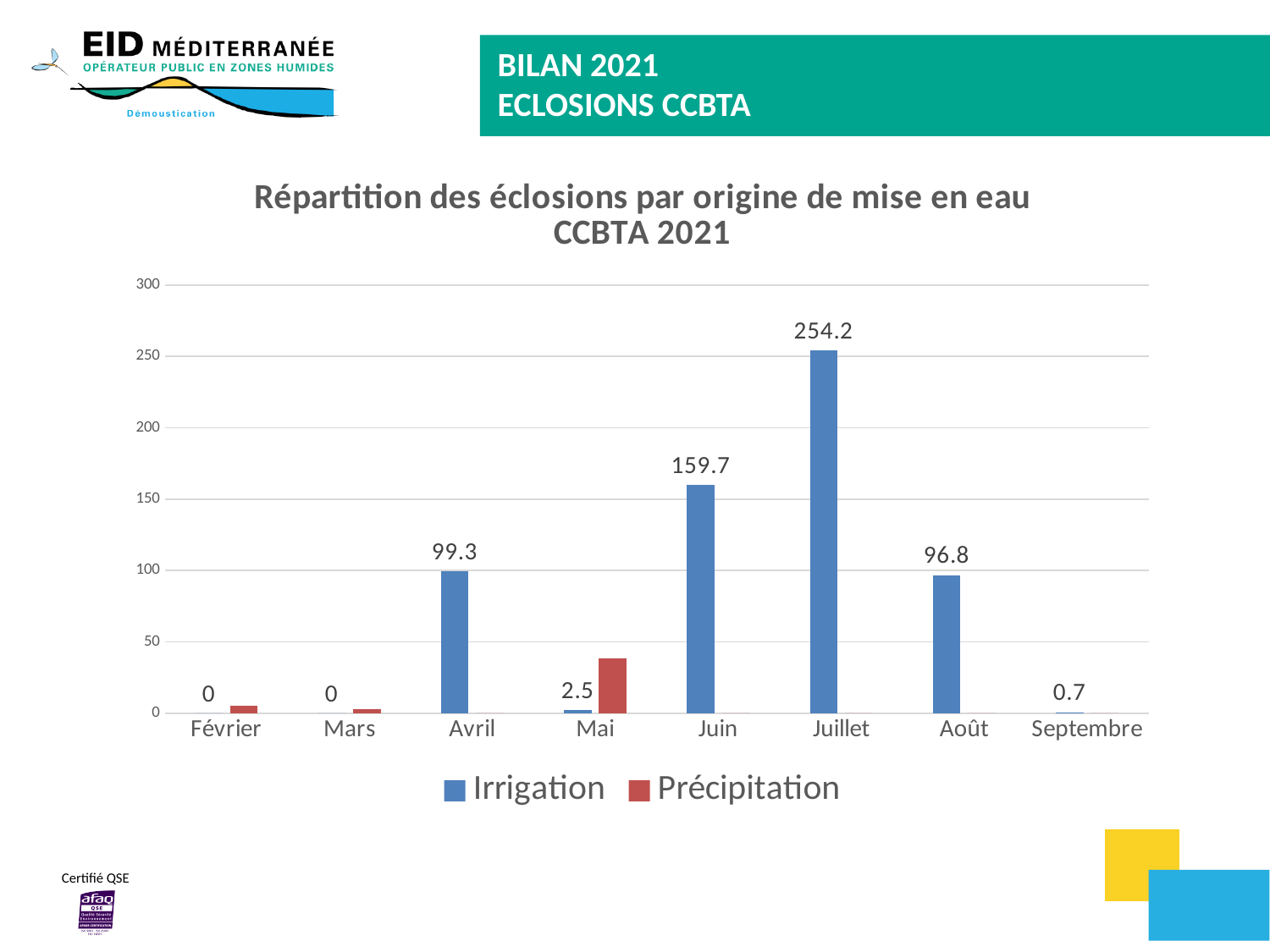
What is the Irrigation value for Septembre? 0.7 Which series is shown in red in the legend? Précipitation What is the Irrigation value for Juillet? 254.2 Is the Précipitation value for Mai greater or less than 50? less What is the Irrigation value for Avril? 99.3 Which month has the highest Irrigation value? Juillet What is the Irrigation value for Juin? 159.7 What is the difference between the Irrigation values for Juillet and Juin? 94.5 Which is larger, the Irrigation value for Avril or for Août? Avril What kind of chart is shown on the slide? bar chart How many series does the legend list? 2 How many months are shown on the x axis? 8